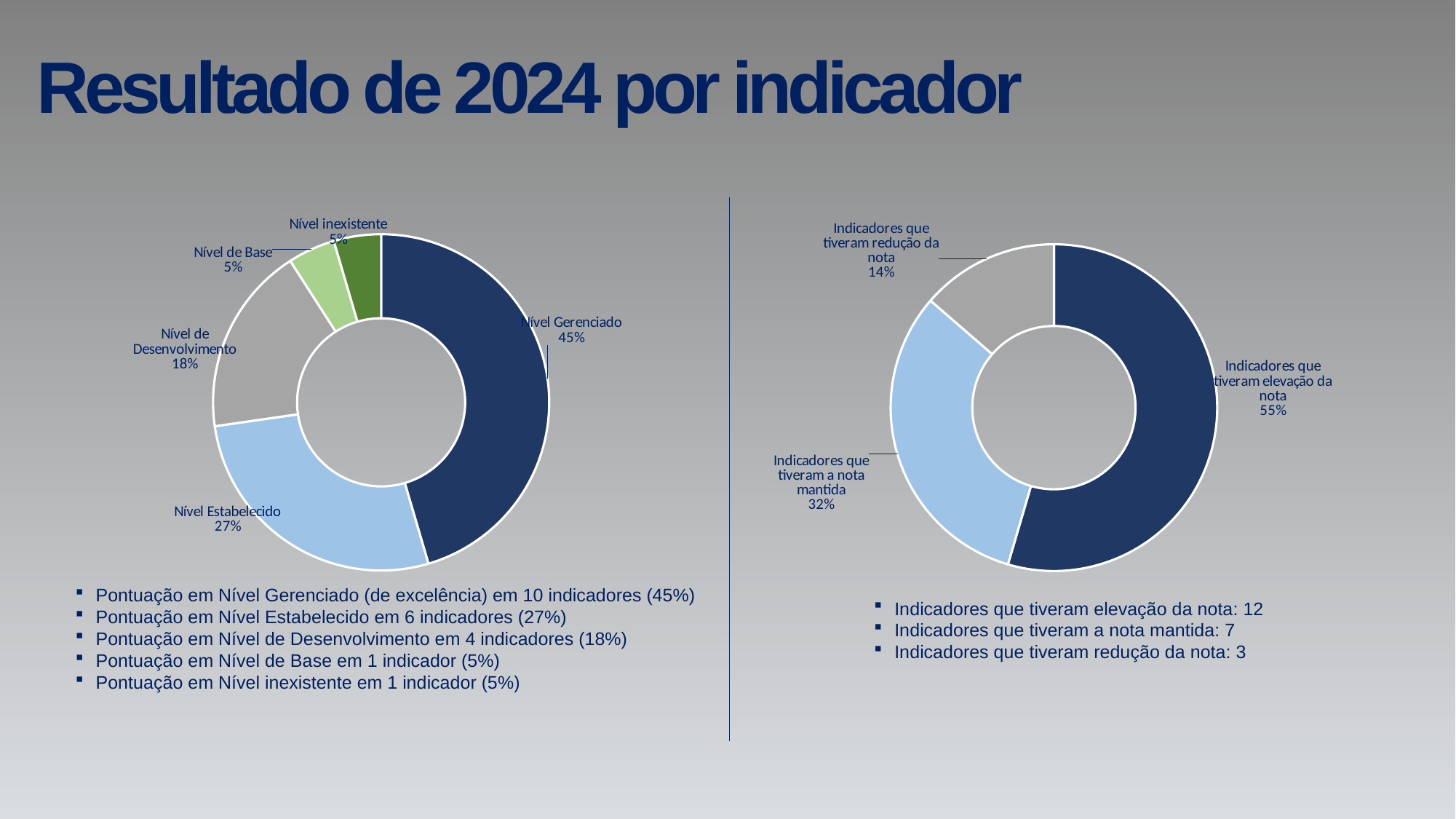
In the right doughnut chart, which category has the smallest share? Indicadores que tiveram redução da nota In the left doughnut chart, what share does Nível Estabelecido have? 27% In the right doughnut chart, how many categories are shown? 3 What type of chart is shown on the left side of the slide? Doughnut (pie) chart In the left doughnut chart, which category has the largest share? Nível Gerenciado In the left doughnut chart, what share does Nível de Desenvolvimento have? 18% In the left doughnut chart, what share does Nível Gerenciado have? 45% In the left doughnut chart, how many categories are shown? 5 In the left doughnut chart, which is larger: Nível de Desenvolvimento or Nível de Base? Nível de Desenvolvimento In the right doughnut chart, what share do the indicators that had their score maintained (Indicadores que tiveram a nota mantida) have? 32% In the left doughnut chart, what is the difference in percentage points between Nível Gerenciado and Nível Estabelecido? 18 In the right doughnut chart, what share do the indicators that had their score raised (Indicadores que tiveram elevação da nota) have? 55%